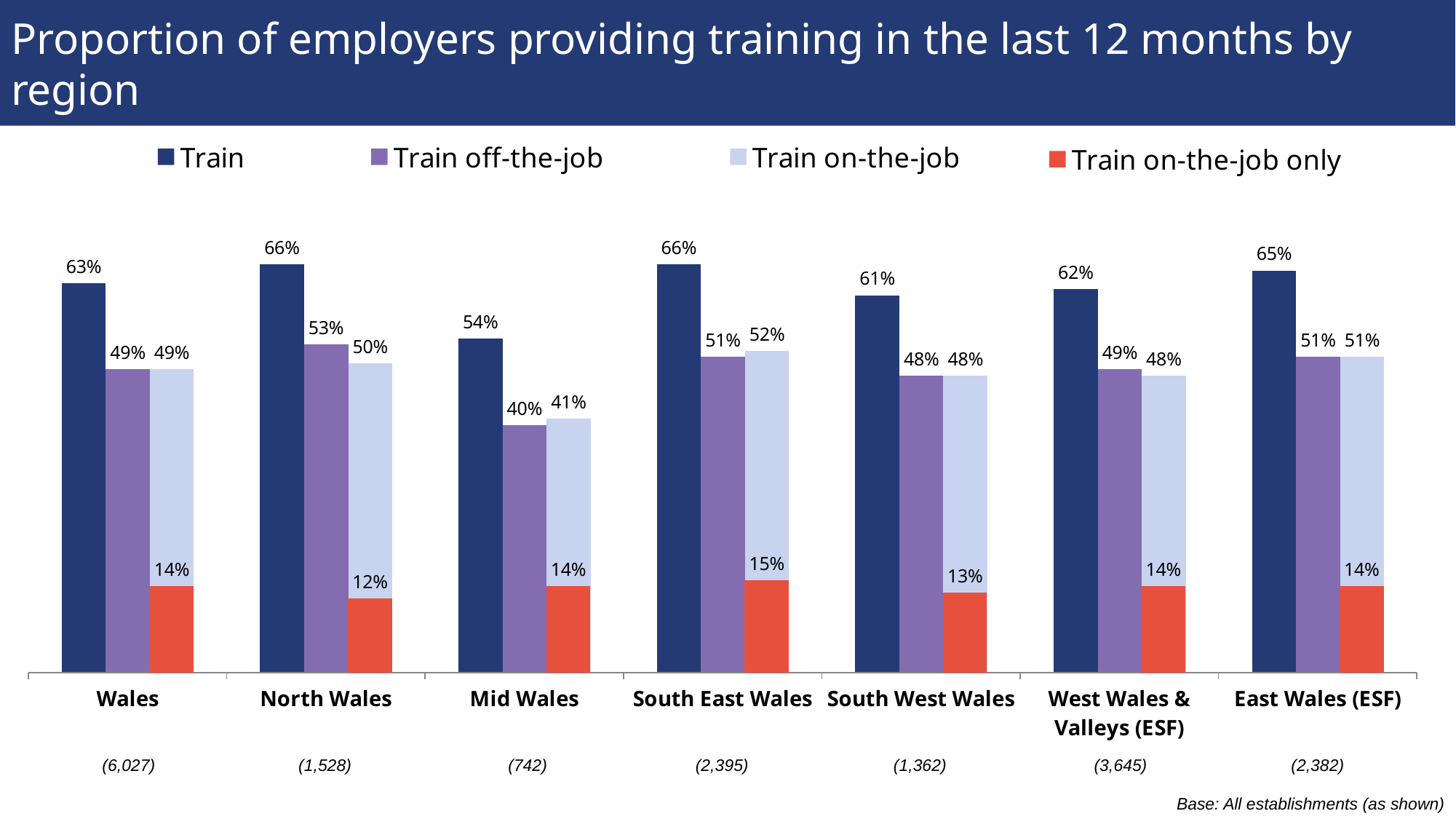
How many regions are shown on the x axis? 7 What percentage of employers in Mid Wales provided training (Train) in the last 12 months? 54% What is the difference between the Train value and the Train off-the-job value for Wales? 14 percentage points What kind of chart is shown on the slide? Bar chart What is the Train on-the-job only value for North Wales? 12% What is the base (number of establishments) shown for West Wales & Valleys (ESF)? 3,645 Which region has the highest value for Train on-the-job only? South East Wales How many series does the legend list? 4 Which region has the highest value for Train off-the-job? North Wales Which region has the lowest value for the Train series? Mid Wales Which is larger for Mid Wales: Train off-the-job or Train on-the-job? Train on-the-job What is the Train off-the-job value for South East Wales? 51%